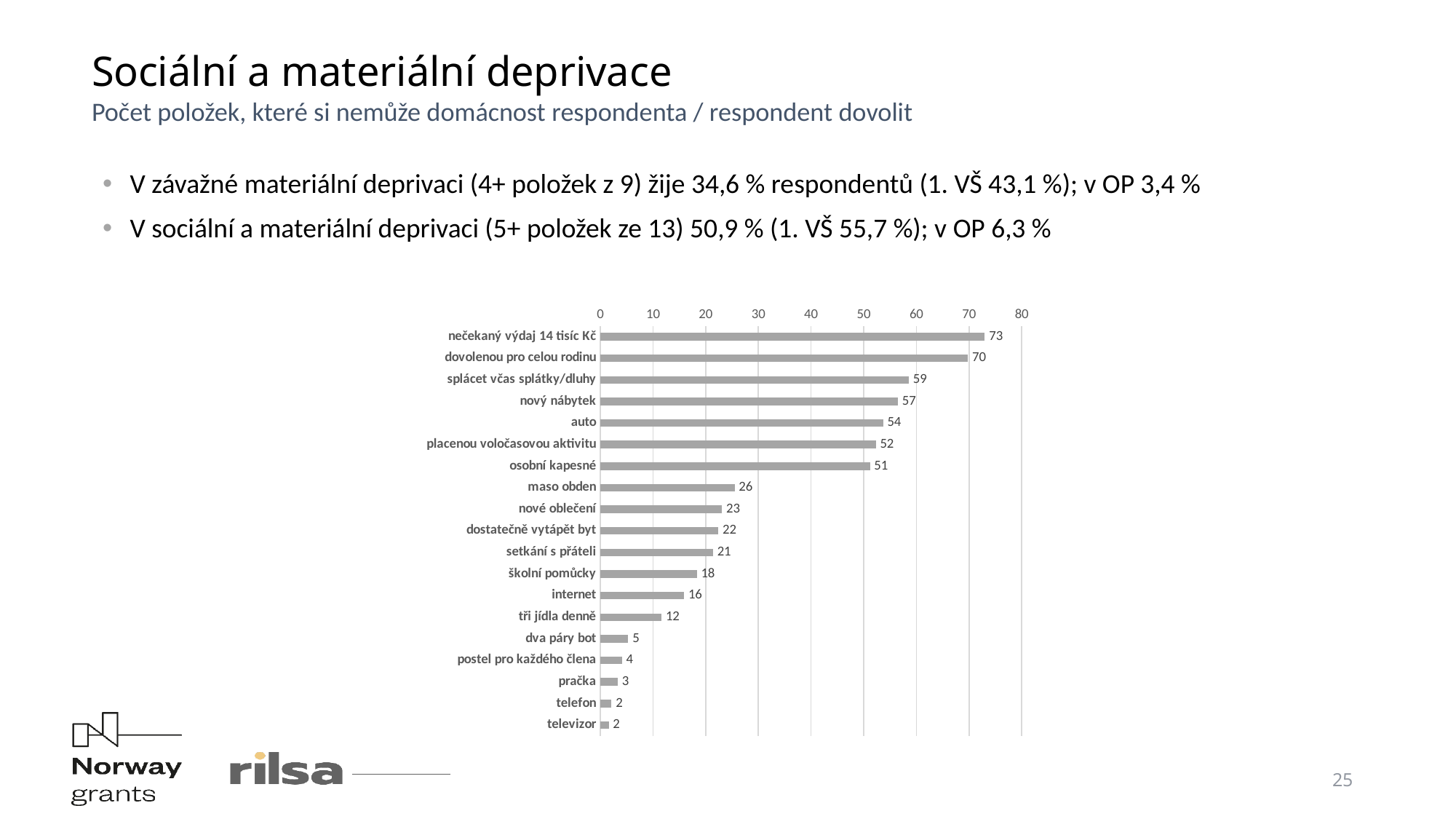
Which is larger, the value for "školní pomůcky" or the value for "setkání s přáteli"? setkání s přáteli What is the value for "internet"? 16 Which is larger, the value for "nový nábytek" or the value for "splácet včas splátky/dluhy"? splácet včas splátky/dluhy What is the value for "osobní kapesné"? 51 What is the value for "auto"? 54 How many categories are shown in the chart? 19 Which category has the highest value? nečekaný výdaj 14 tisíc Kč What is the difference between the values for "nečekaný výdaj 14 tisíc Kč" and "dovolenou pro celou rodinu"? 3 What kind of chart is shown on the slide? bar chart Is the value for "placenou voločasovou aktivitu" greater or less than 40? greater What is the value for "dva páry bot"? 5 What is the difference between the values for "maso obden" and "tři jídla denně"? 14